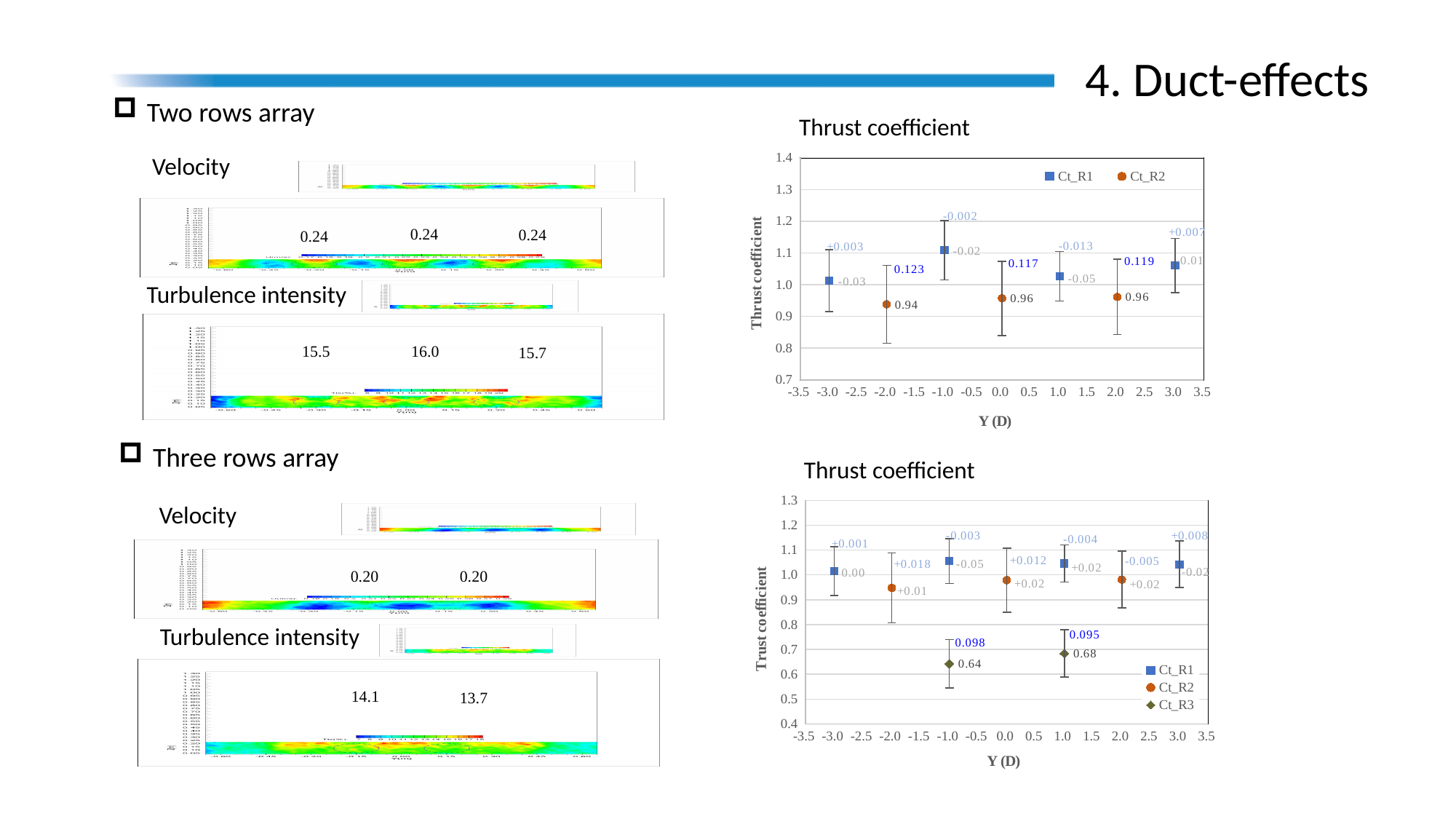
In the bottom 'Thrust coefficient' chart, what is the Ct_R3 value at Y = 1.0? 0.68 What is the x-axis title of the bottom 'Thrust coefficient' chart? Y (D) In the bottom 'Thrust coefficient' chart, what is the difference between the Ct_R3 values at Y = 1.0 and Y = -1.0? 0.04 How many series does the legend of the top 'Thrust coefficient' chart list? 2 In the bottom 'Thrust coefficient' chart, what is the Ct_R3 value at Y = -1.0? 0.64 What kind of chart is the top 'Thrust coefficient' chart (two rows array)? scatter chart In the top 'Thrust coefficient' chart, is the Ct_R2 value at Y = 0.0 greater or less than 1.0? less In the bottom 'Thrust coefficient' chart, at Y = 1.0, which is larger: Ct_R1 or Ct_R3? Ct_R1 How many series does the legend of the bottom 'Thrust coefficient' chart (three rows array) list? 3 In the top 'Thrust coefficient' chart, what is the Ct_R2 value at Y = -2.0? 0.94 In the top 'Thrust coefficient' chart, is the Ct_R1 value at Y = -1.0 greater or less than 1.0? greater How many Ct_R2 data points are plotted in the top 'Thrust coefficient' chart? 3